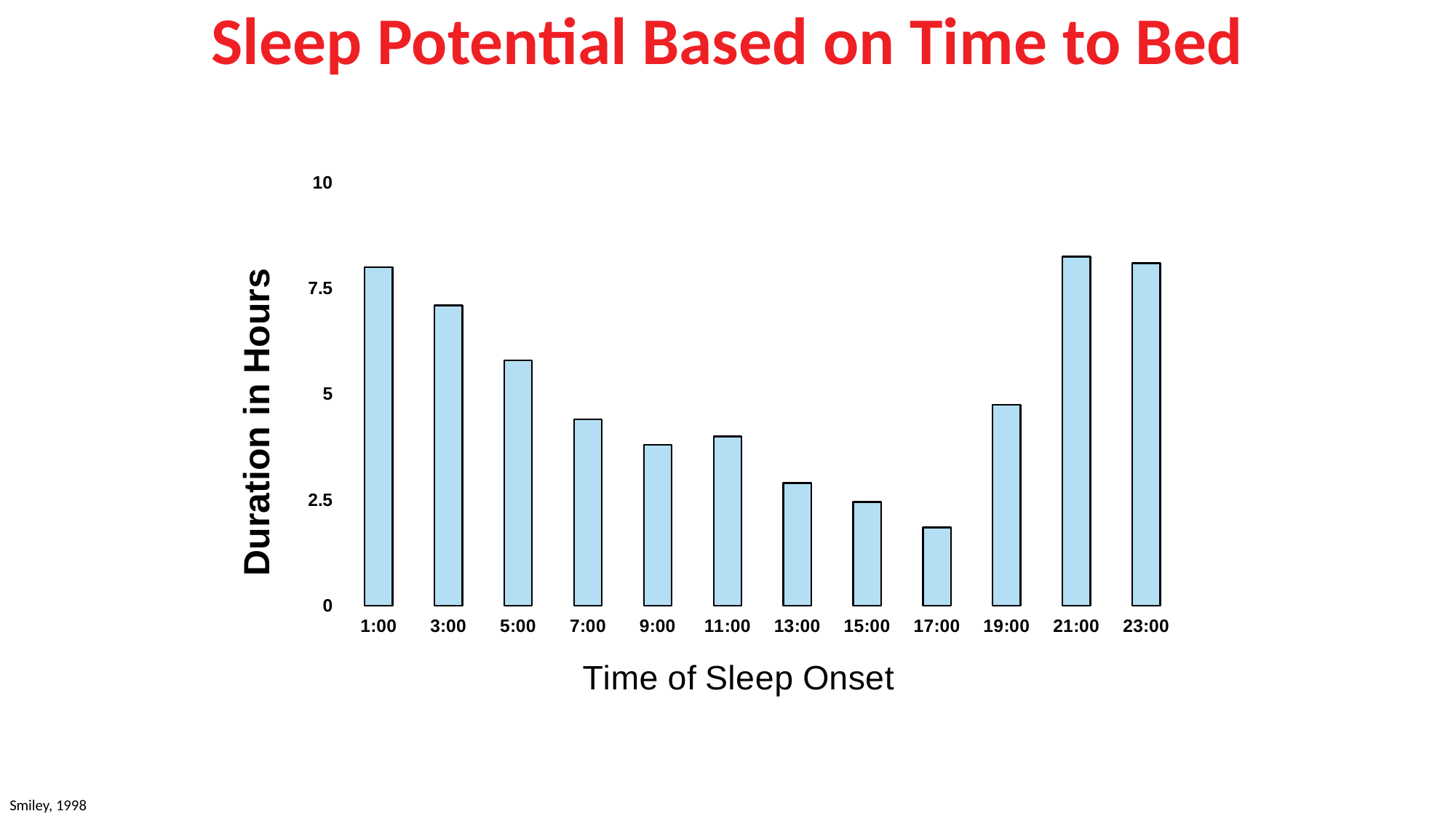
Which has a longer duration in hours, 19:00 or 9:00? 19:00 What is the title of the vertical axis? Duration in Hours Do the values rise or fall from 1:00 to 17:00 along the x axis? fall Is the value for 5:00 greater or less than 5? greater What kind of chart is shown on the slide? bar chart Is the value for 1:00 greater or less than 7.5? greater How many time-of-sleep-onset categories are plotted on the x axis? 12 Which has a longer duration in hours, 1:00 or 3:00? 1:00 Is the value for 21:00 greater or less than 7.5? greater Which time of sleep onset has the lowest duration in hours? 17:00